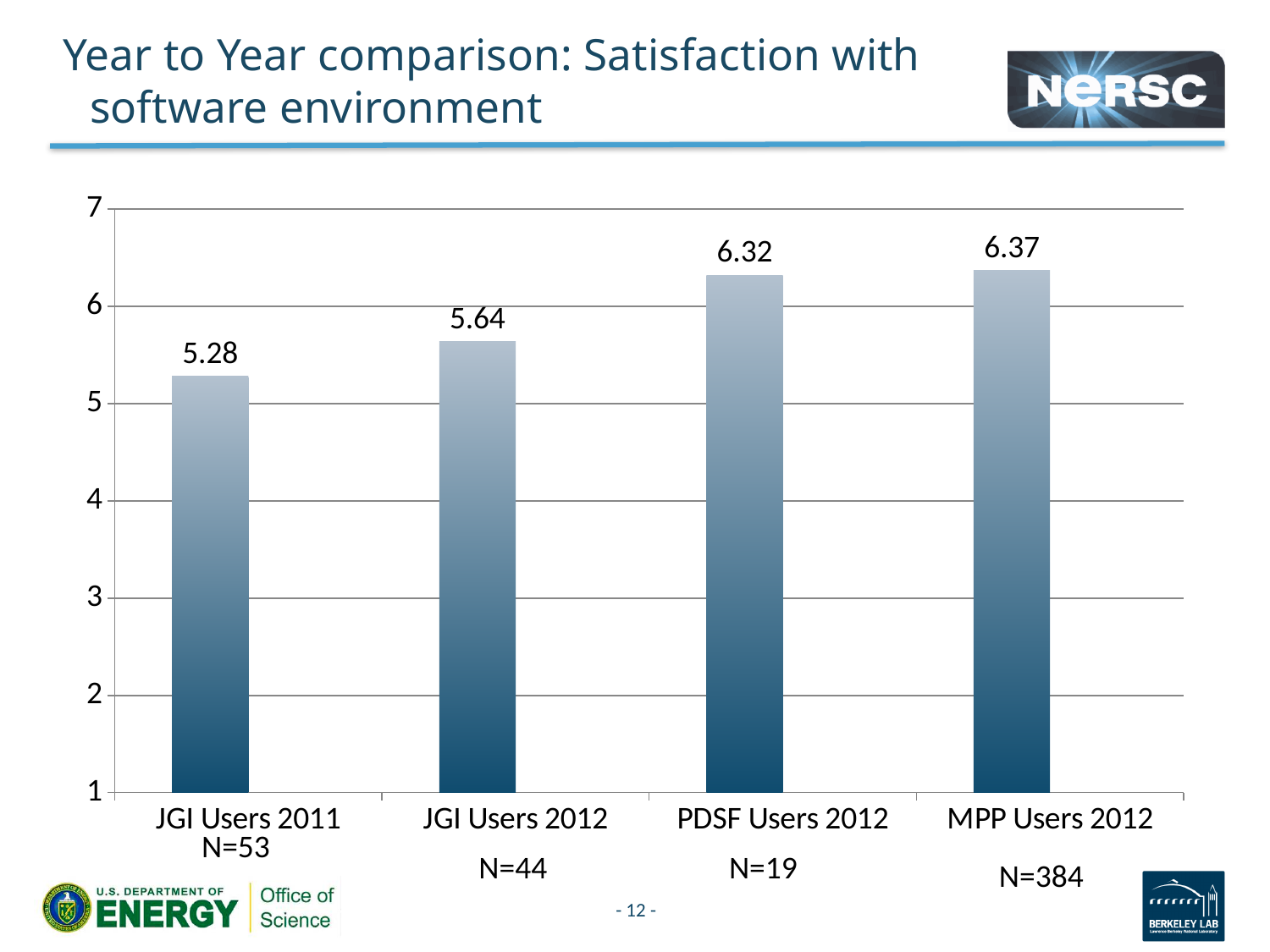
Do the values rise or fall from left to right across the categories? rise Which is larger, the value for JGI Users 2012 or the value for PDSF Users 2012? PDSF Users 2012 What is the difference between the values for JGI Users 2012 and JGI Users 2011? 0.36 What is the satisfaction value for MPP Users 2012? 6.37 How many categories are shown on the chart? 4 Which category has the highest value? MPP Users 2012 Which category has the lowest value? JGI Users 2011 Is the value for JGI Users 2012 greater or less than 6? less What is the N value shown for MPP Users 2012? N=384 What is the satisfaction value for PDSF Users 2012? 6.32 What is the satisfaction value for JGI Users 2011? 5.28 What kind of chart is shown on the slide? bar chart